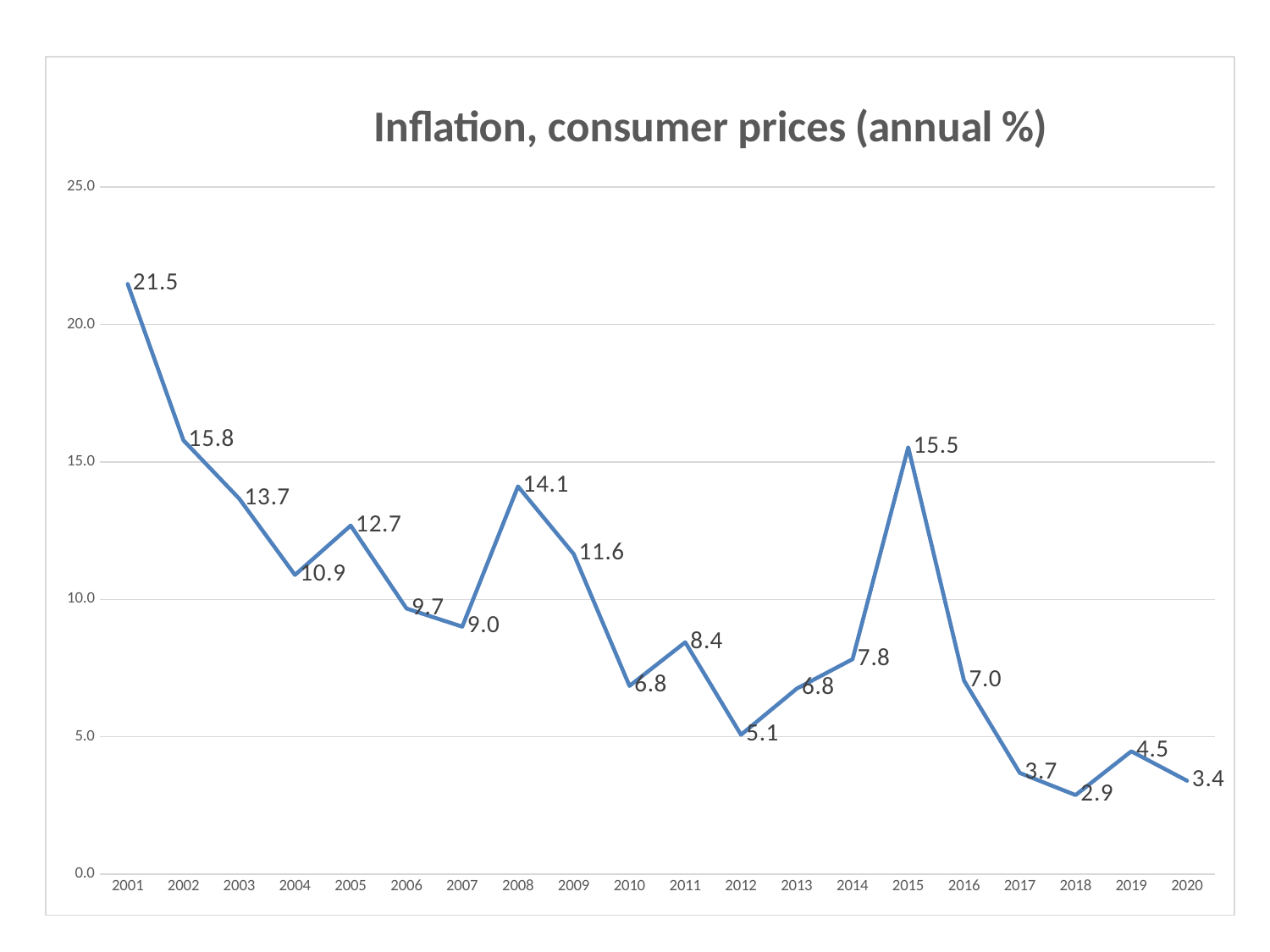
Does the inflation value rise or fall from 2011 to 2012? fall Is the inflation value for 2002 greater or less than 15.0? greater Which year has a higher inflation value, 2005 or 2016? 2005 What is the inflation value for 2001? 21.5 What is the difference between the inflation values for 2008 and 2009? 2.5 What kind of chart is shown on the slide? line chart How many years are plotted on the chart? 20 Which year has the highest inflation value? 2001 What is the title of the chart? Inflation, consumer prices (annual %) What is the inflation value for 2015? 15.5 Which year has the lowest inflation value? 2018 What is the inflation value for 2018? 2.9